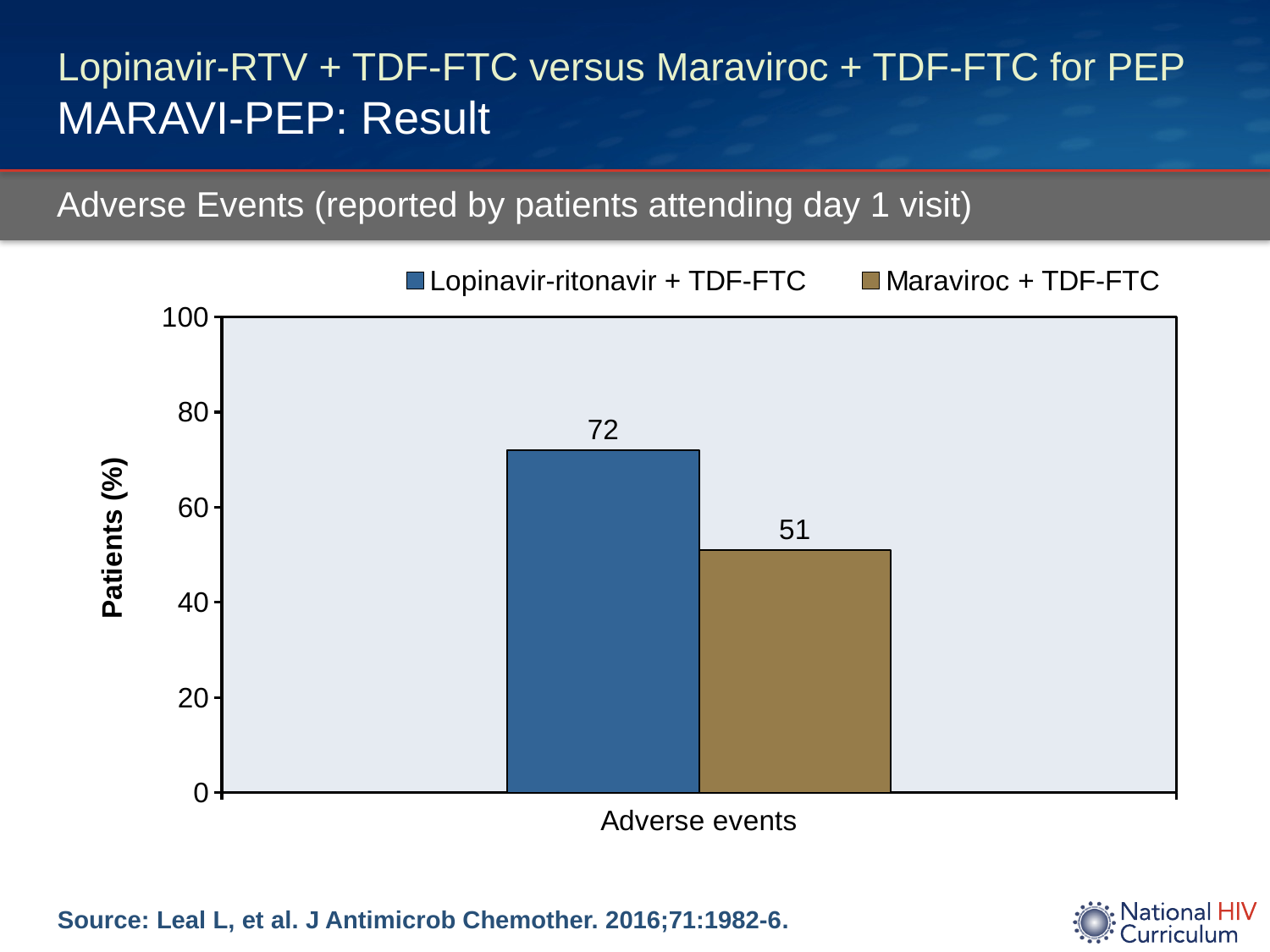
Is the adverse events value for Maraviroc + TDF-FTC larger or smaller than that for Lopinavir-ritonavir + TDF-FTC? smaller Is the value for Lopinavir-ritonavir + TDF-FTC greater or less than 60? greater Which group had the higher percentage of patients with adverse events? Lopinavir-ritonavir + TDF-FTC What percentage of patients reported adverse events in the Lopinavir-ritonavir + TDF-FTC group? 72 What kind of chart is shown on the slide? bar chart What is the difference in percentage points between the Lopinavir-ritonavir + TDF-FTC and Maraviroc + TDF-FTC groups for adverse events? 21 What percentage of patients reported adverse events in the Maraviroc + TDF-FTC group? 51 How many series does the legend list? 2 What is the label of the y axis? Patients (%) Which group had the lower percentage of patients with adverse events? Maraviroc + TDF-FTC How many categories are shown on the x axis? 1 Is the value for Maraviroc + TDF-FTC greater or less than 60? less